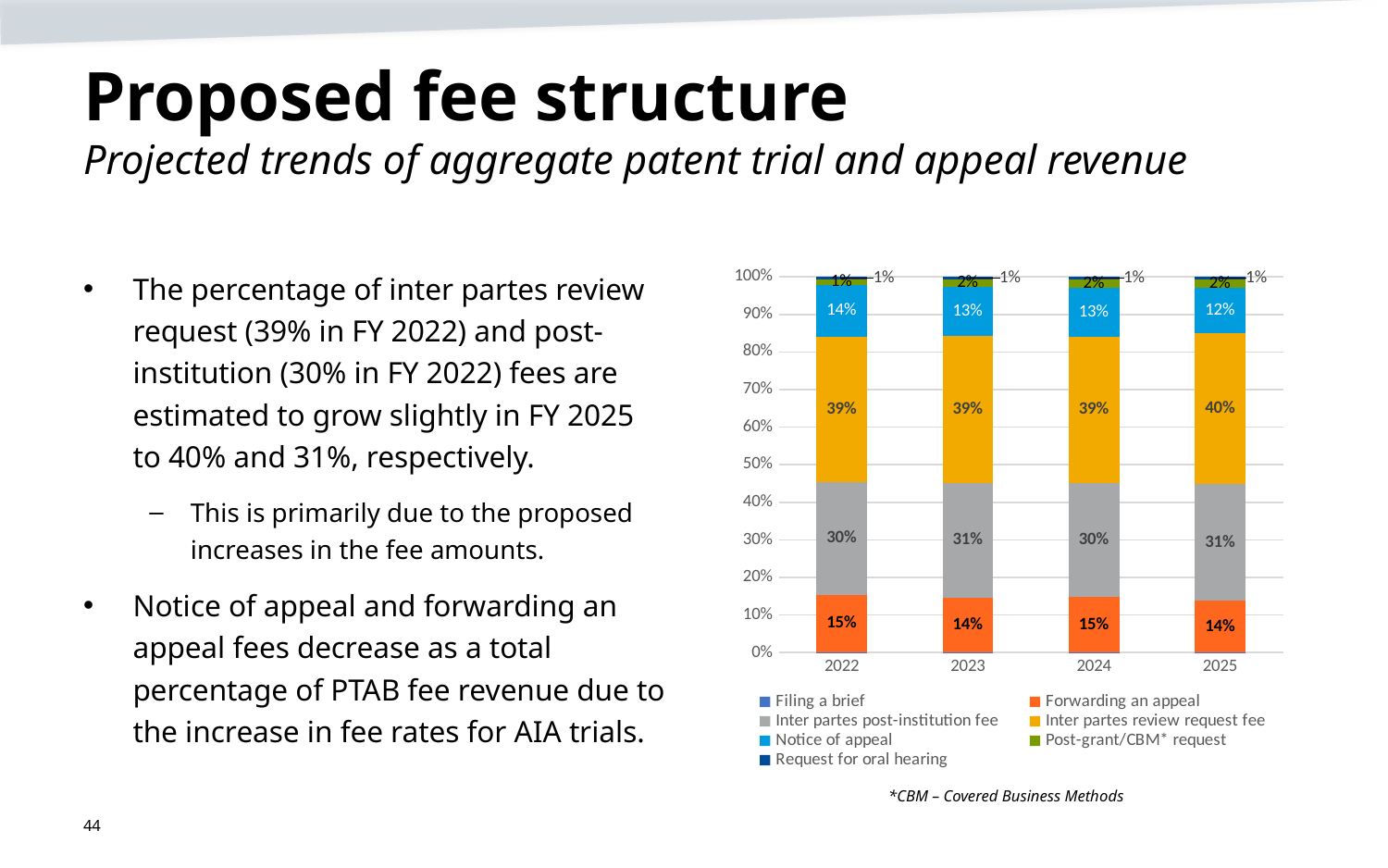
What is the difference between the notice of appeal value in 2022 and in 2025? 2% What kind of chart is shown on the slide? Stacked bar chart What is the value for forwarding an appeal in 2024? 15% What is the value for post-grant/CBM request in 2022? 1% What is the value for the inter partes review request fee in 2025? 40% How many years are shown on the x axis of the chart? 4 How many series does the chart legend list? 7 What is the value for notice of appeal in 2025? 12% Which series has the largest share in 2022? Inter partes review request fee What is the value for the inter partes post-institution fee in 2023? 31% Which is larger in 2023: the inter partes post-institution fee or the notice of appeal? Inter partes post-institution fee Does the notice of appeal share rise or fall from 2022 to 2025? Fall